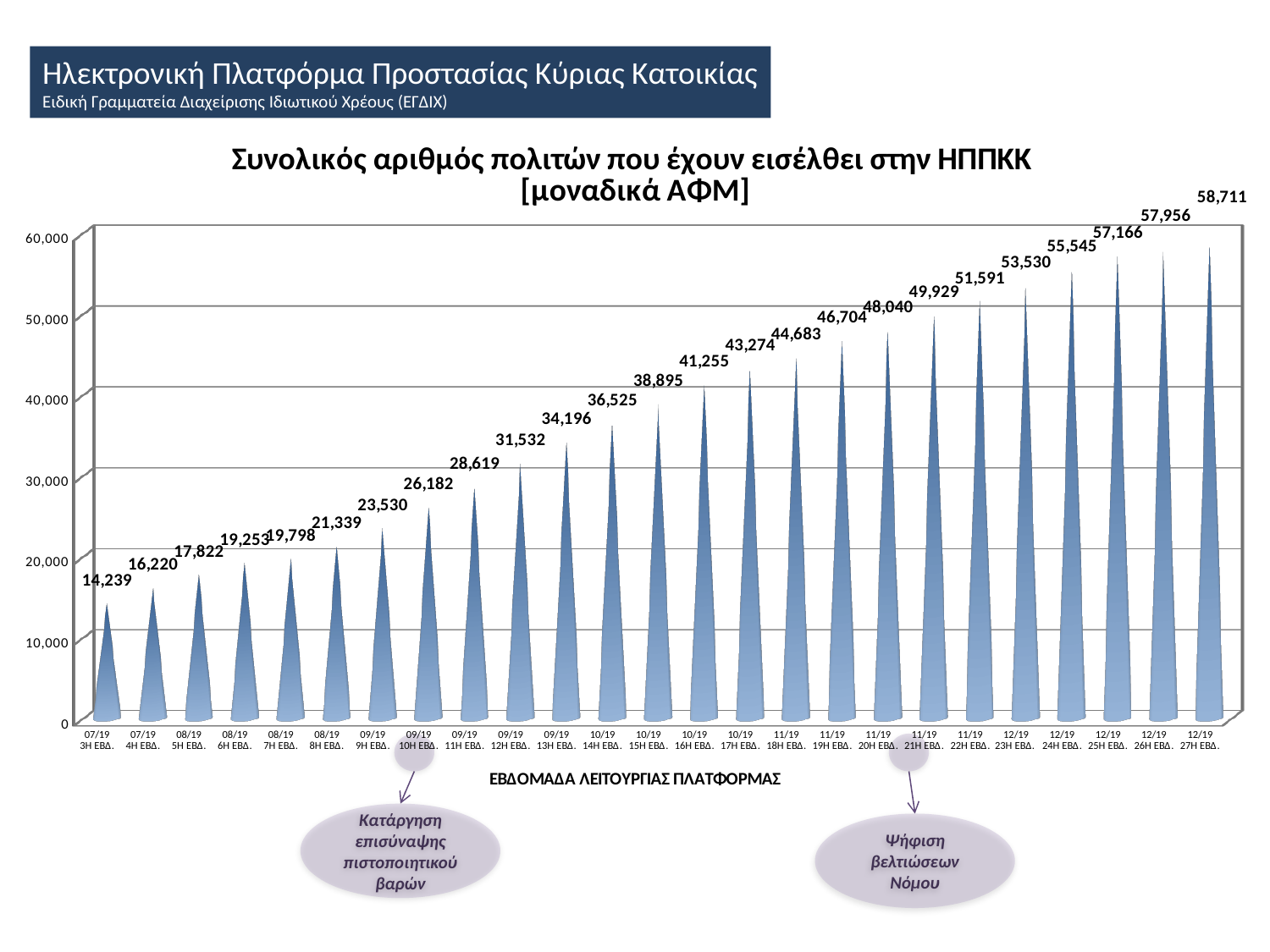
Do the values rise or fall from left to right along the x axis? Rise What is the difference between the values for 26Η ΕΒΔ. and 25Η ΕΒΔ.? 790 Which week has the highest value? 27Η ΕΒΔ. (12/19) Which is larger, the value for 10Η ΕΒΔ. or the value for 12Η ΕΒΔ.? 12Η ΕΒΔ. What is the value for 15Η ΕΒΔ. (10/19)? 38,895 What is the value for 27Η ΕΒΔ. (12/19), the last week shown? 58,711 Which week has the lowest value? 3Η ΕΒΔ. (07/19) What is the value for 21Η ΕΒΔ. (11/19)? 49,929 What kind of chart is shown on the slide? Bar chart What is the value for 3Η ΕΒΔ. (07/19), the first week shown? 14,239 What is the difference between the values for 27Η ΕΒΔ. and 3Η ΕΒΔ.? 44,472 How many weeks (categories) are plotted on the chart? 25